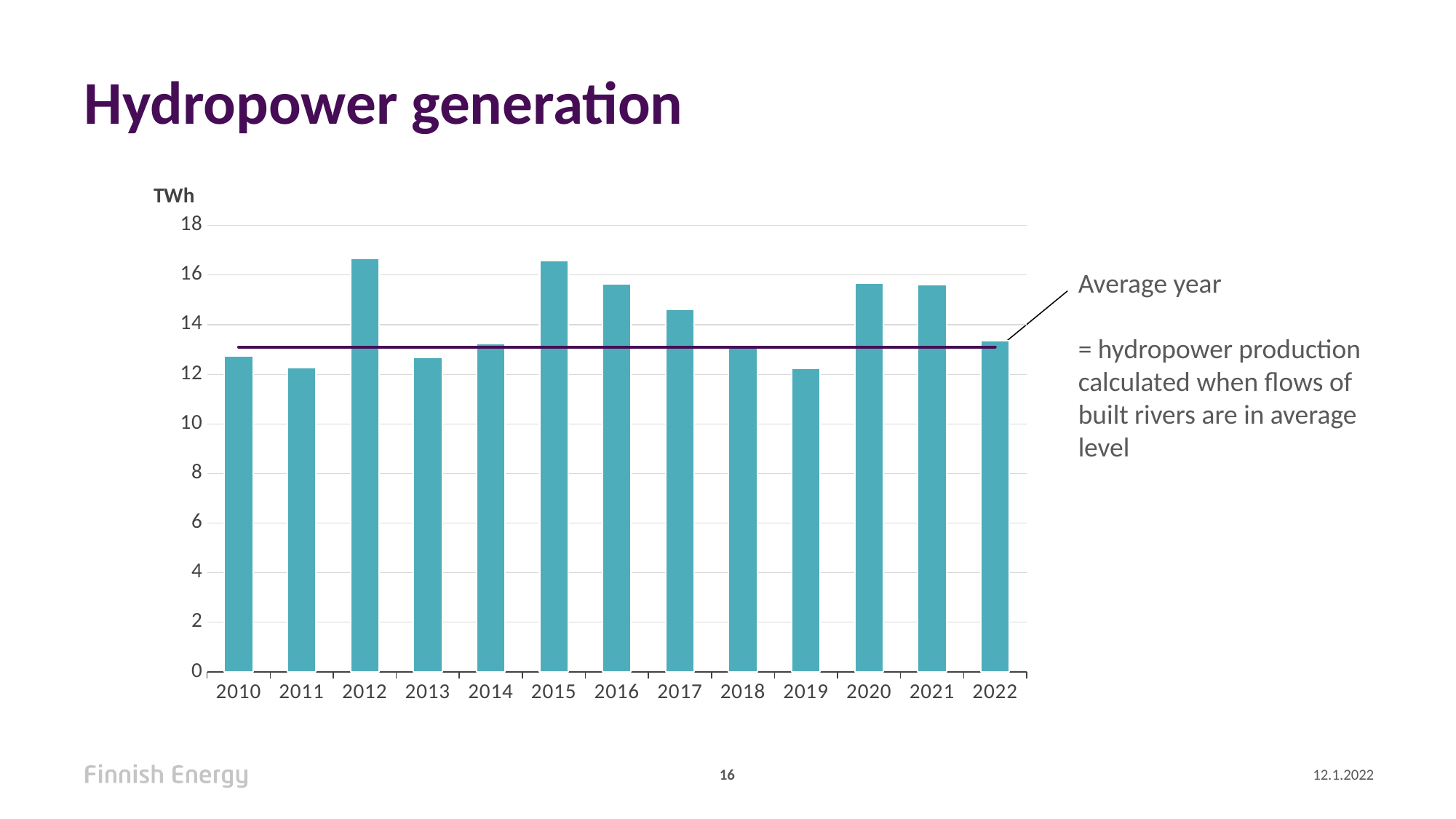
Which is larger, the value for 2012 or the value for 2019? 2012 Is the value for 2012 greater or less than 16? greater Is the value for 2011 greater or less than 14? less Is the value for 2019 greater or less than 14? less Which is larger, the value for 2016 or the value for 2013? 2016 What kind of chart is shown on the slide? bar chart How many years are shown on the x axis of the chart? 13 Which is larger, the value for 2017 or the value for 2018? 2017 What unit is shown on the y axis of the chart? TWh What does the horizontal line across the chart represent? Average year